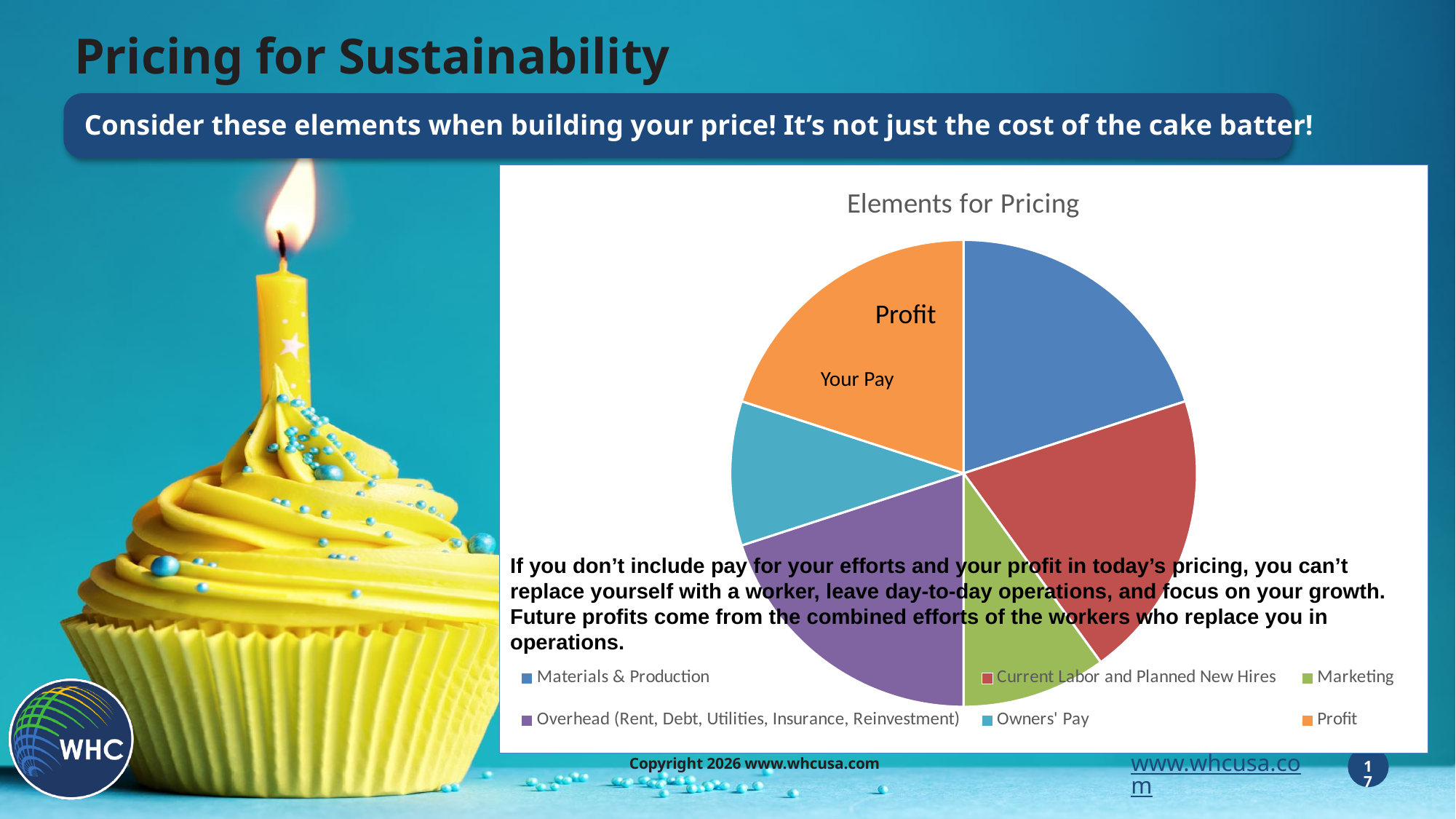
Which colour represents Profit in the pie chart? orange Which slice is larger, Profit or Owners' Pay? Profit How many entries does the chart legend list? 6 Which slice is larger, Current Labor and Planned New Hires or Marketing? Current Labor and Planned New Hires Which slice is larger, Materials & Production or Marketing? Materials & Production How many slices does the pie chart have? 6 What is the title of the chart? Elements for Pricing What kind of chart is shown on the slide? pie chart